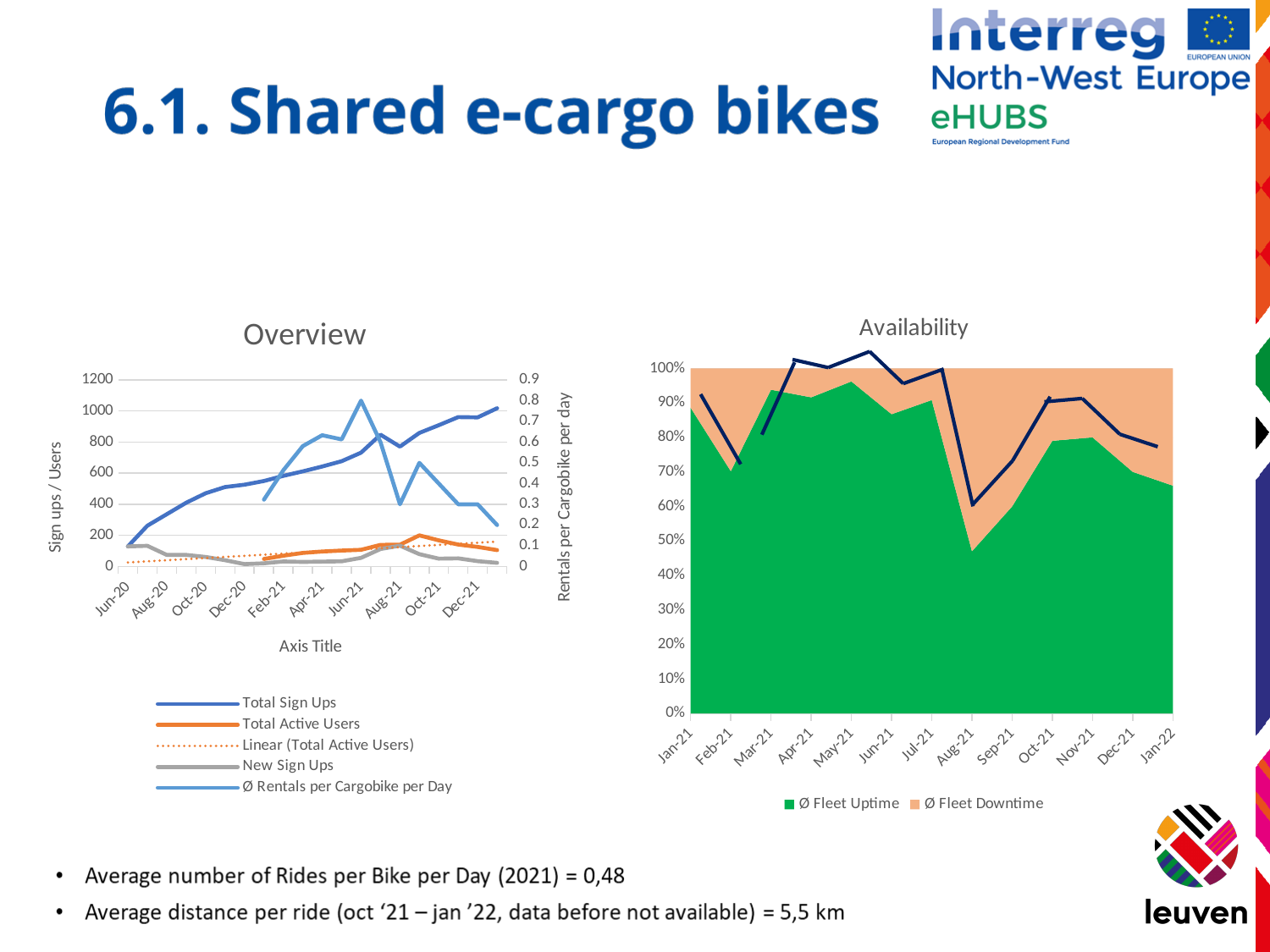
How many series does the legend of the Overview chart list? 5 In the Availability chart, is the Ø Fleet Uptime for Jan-21 greater or less than 80%? greater In the Overview chart, is the value of Total Sign Ups at Dec-21 greater or less than 800? greater How many series does the legend of the Availability chart list? 2 In the Availability chart, how many months are labelled on the x axis? 13 What kind of chart is the Availability chart? stacked area chart What is the title of the right-hand vertical axis of the Overview chart? Rentals per Cargobike per day In the Overview chart, is the value of Total Sign Ups at Jun-20 greater or less than 200? less In the Availability chart, which month has the lowest Ø Fleet Uptime? Aug-21 What kind of chart is the Overview chart? line chart In the Overview chart, does the Total Sign Ups series rise or fall from Jun-20 to Dec-21? rise